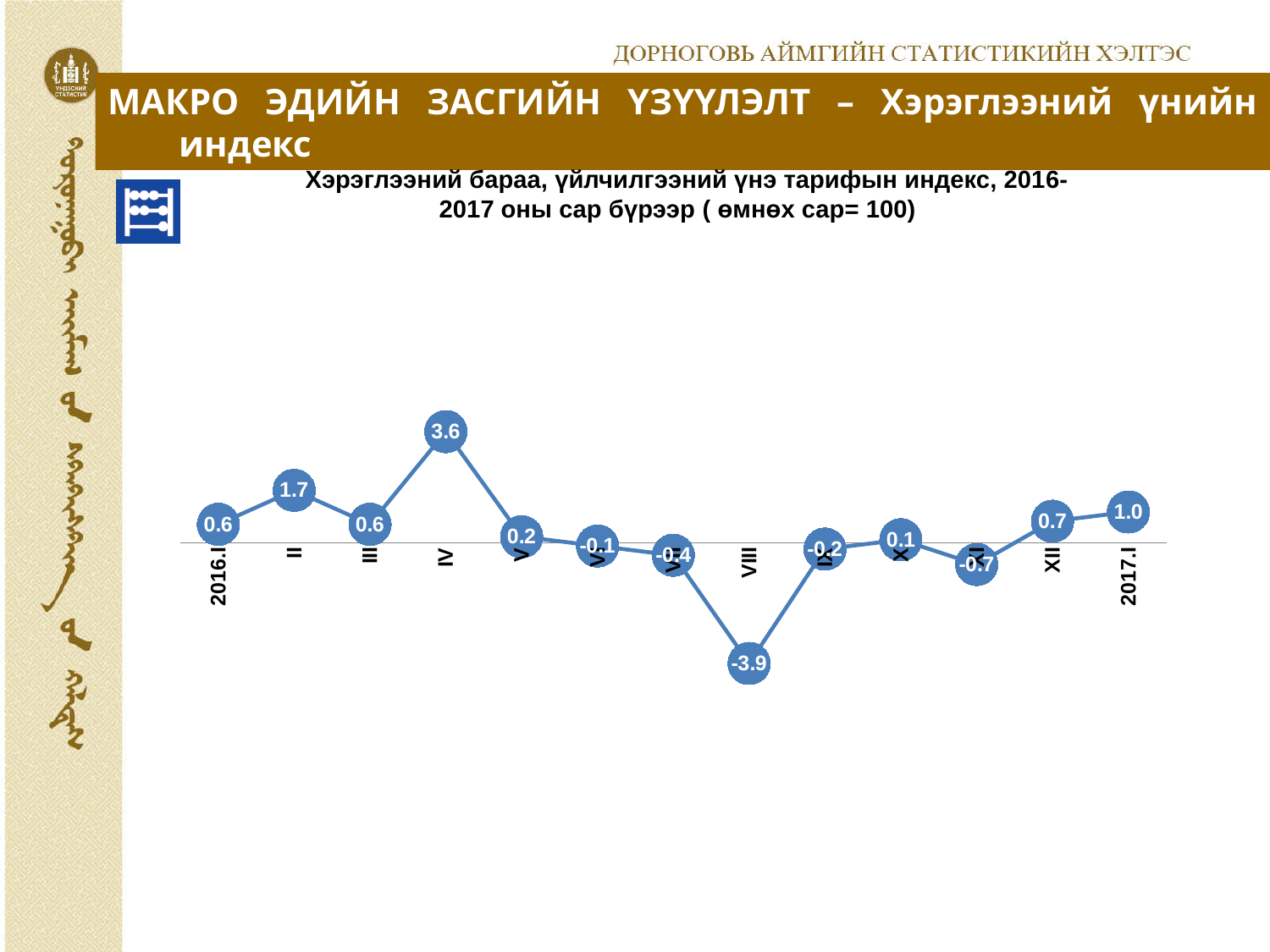
What is the value for IV (April 2016)? 3.6 Which month has the highest value? IV Which month has the lowest value? VIII How many data points are plotted on the chart? 13 What is the value for XII (December 2016)? 0.7 Does the value rise or fall from IV to V? fall What is the value for II (February 2016)? 1.7 What is the value for 2017.I? 1.0 What is the value for VIII (August 2016)? -3.9 What is the difference between the values for IV and II? 1.9 What type of chart is shown on the slide? line chart Which is larger, the value for II or the value for XII? II